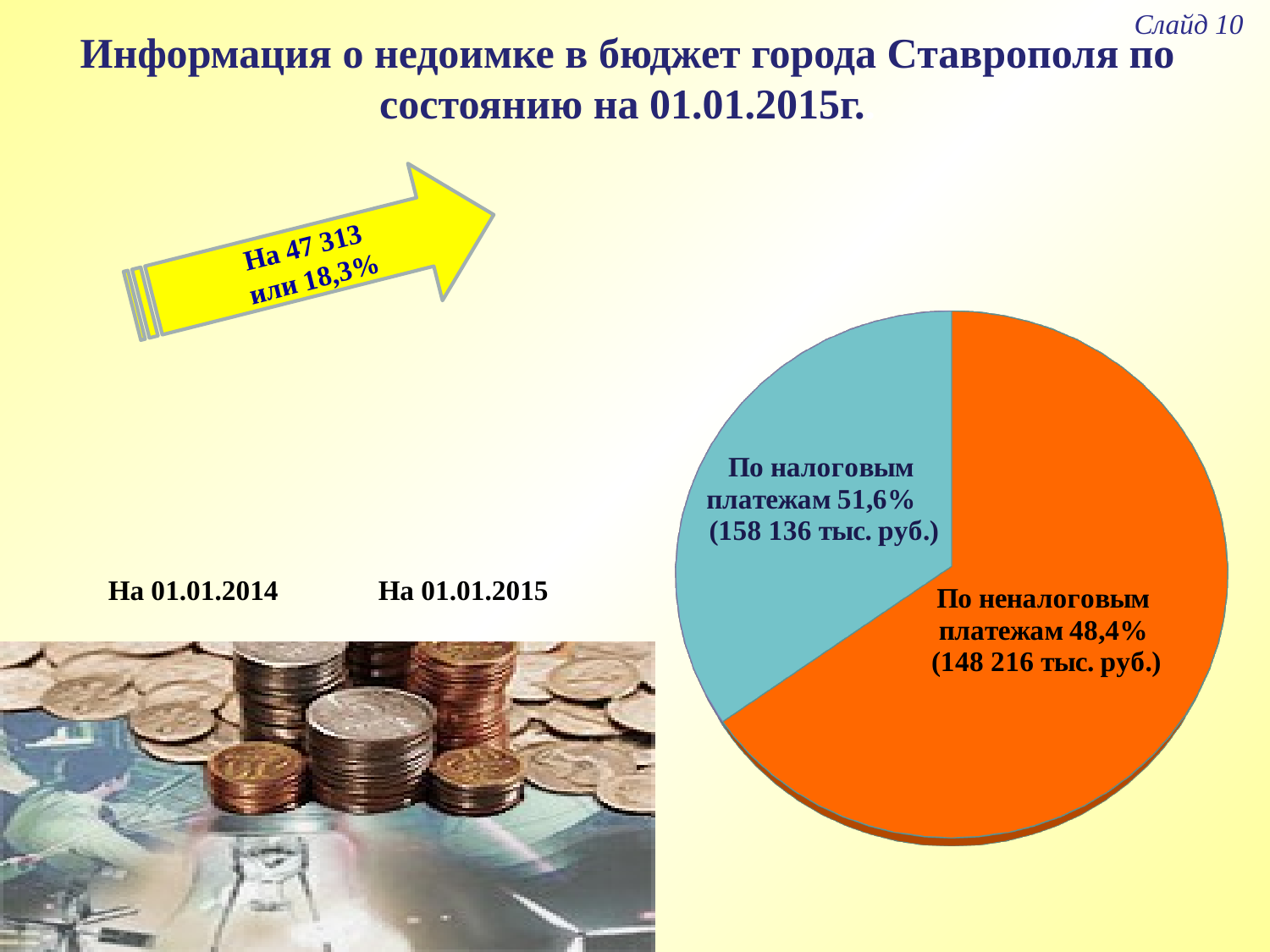
What amount in тыс. руб. is shown for 'По неналоговым платежам' in the pie chart? 148 216 тыс. руб. What colour is the slice labelled 'По неналоговым платежам' in the pie chart? orange What amount in тыс. руб. is shown for 'По налоговым платежам' in the pie chart? 158 136 тыс. руб. How many slices does the pie chart have? 2 What is the total of the two amounts labelled on the pie chart, in тыс. руб.? 306 352 тыс. руб. What colour is the slice labelled 'По налоговым платежам' in the pie chart? teal (light blue-green) What percentage does the pie chart show for 'По неналоговым платежам'? 48,4% By how many percentage points does the labelled share for 'По налоговым платежам' exceed that for 'По неналоговым платежам'? 3,2% What kind of chart is shown on the right side of the slide? pie chart What percentage does the pie chart show for 'По налоговым платежам'? 51,6% What is the difference in тыс. руб. between the labelled amounts for 'По налоговым платежам' and 'По неналоговым платежам'? 9 920 тыс. руб.